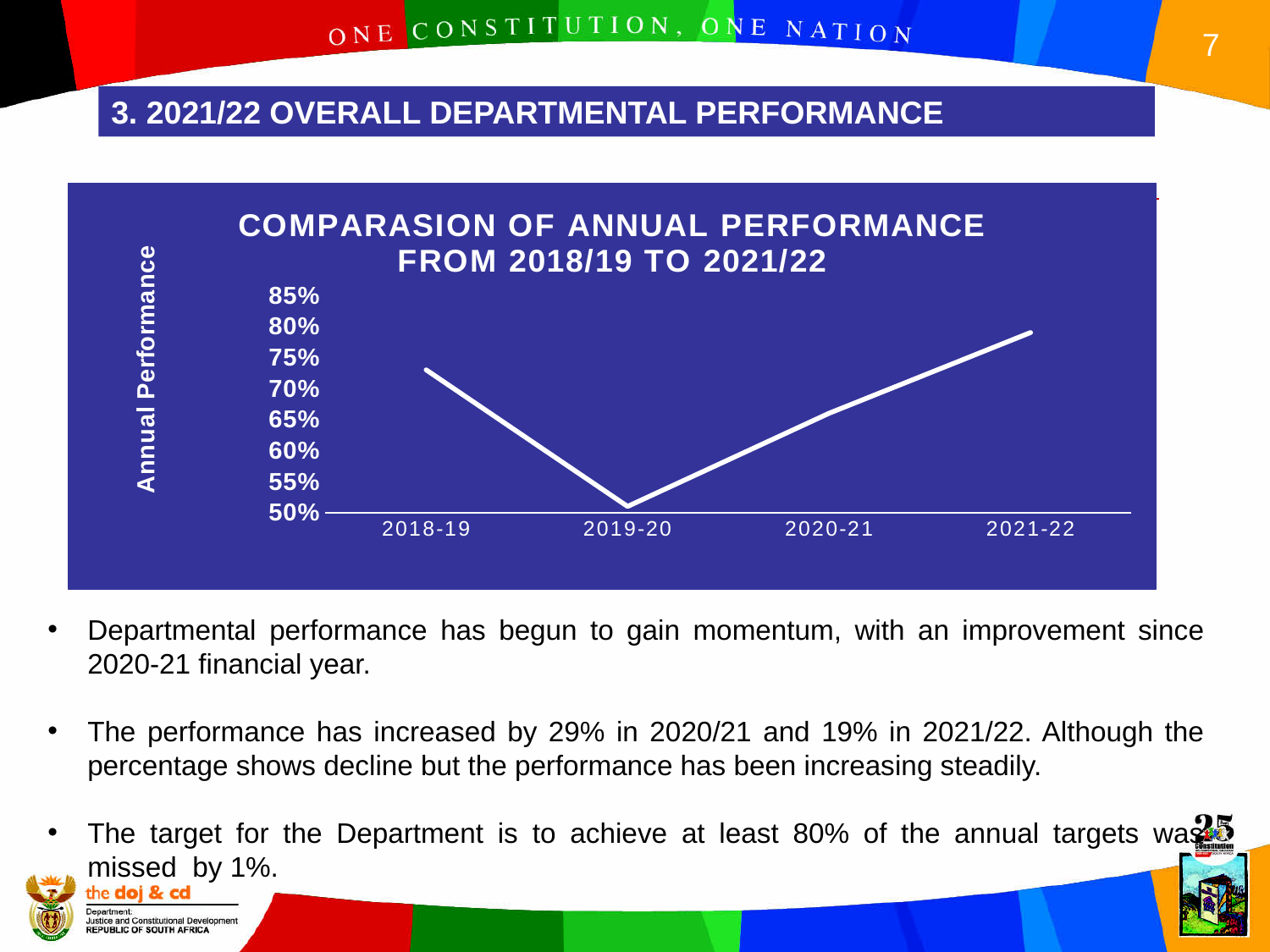
How many financial years are plotted on the x axis of the chart? 4 Which is larger, the annual performance for 2018-19 or for 2020-21? 2018-19 Is the annual performance for 2018-19 greater or less than 70%? greater Does the annual performance rise or fall from 2019-20 to 2021-22? rise Is the annual performance for 2021-22 greater or less than 75%? greater Is the annual performance for 2019-20 greater or less than 55%? less What is the title of the chart? COMPARASION OF ANNUAL PERFORMANCE FROM 2018/19 TO 2021/22 What kind of chart is shown on the slide? line chart What is the label on the vertical axis of the chart? Annual Performance Which financial year has the lowest annual performance in the chart? 2019-20 Which financial year has the highest annual performance in the chart? 2021-22